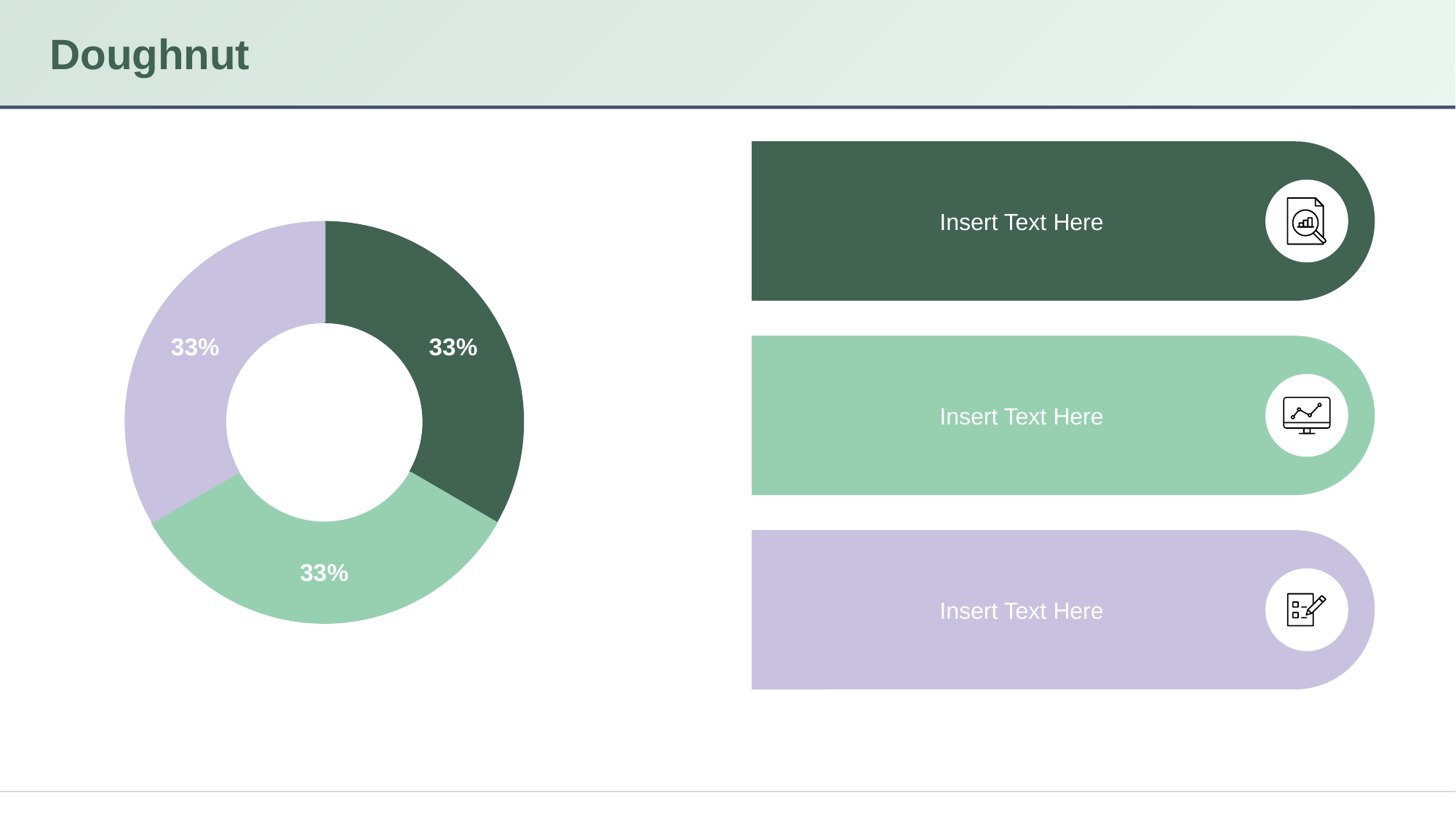
Is the value of the lavender slice greater or less than 25%? greater What kind of chart is shown on the slide? doughnut chart How many slices does the doughnut chart have? 3 What value is labelled on the dark green slice of the doughnut chart? 33% What is the title of the slide containing the doughnut chart? Doughnut Is the value of the light green slice greater or less than 50%? less Is the dark green slice larger or smaller than the lavender slice, or are they the same? the same What value is labelled on the light green slice of the doughnut chart? 33% What value is labelled on the lavender slice of the doughnut chart? 33% Does the doughnut chart include a legend? No What is the difference between the values of the light green slice and the dark green slice? 0%